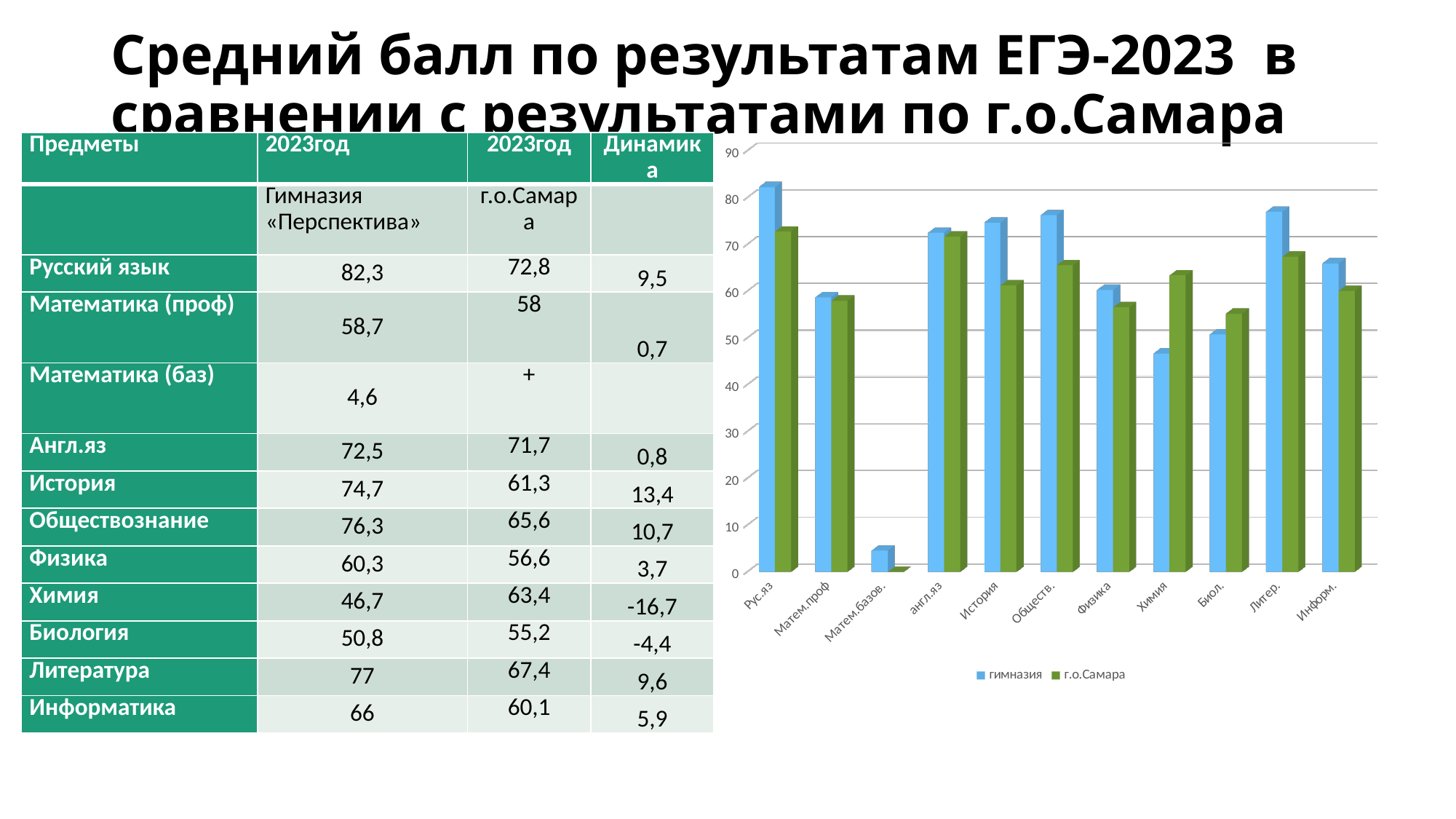
Is the гимназия value for Рус.яз greater or less than 80? greater What kind of chart is shown on the right of the slide? bar chart Which category has the lowest value for the гимназия series in the chart? Матем.базов. Is the гимназия value for Химия greater or less than 50? less Is the г.о.Самара value for Обществ. greater or less than 60? greater For Химия, which series has the larger value in the chart, гимназия or г.о.Самара? г.о.Самара What are the two legend entries of the chart? гимназия, г.о.Самара How many subject categories are plotted along the x axis of the chart? 11 Which category has the highest value for the гимназия series in the chart? Рус.яз How many series does the chart legend list? 2 For История, which series has the larger value in the chart, гимназия or г.о.Самара? гимназия